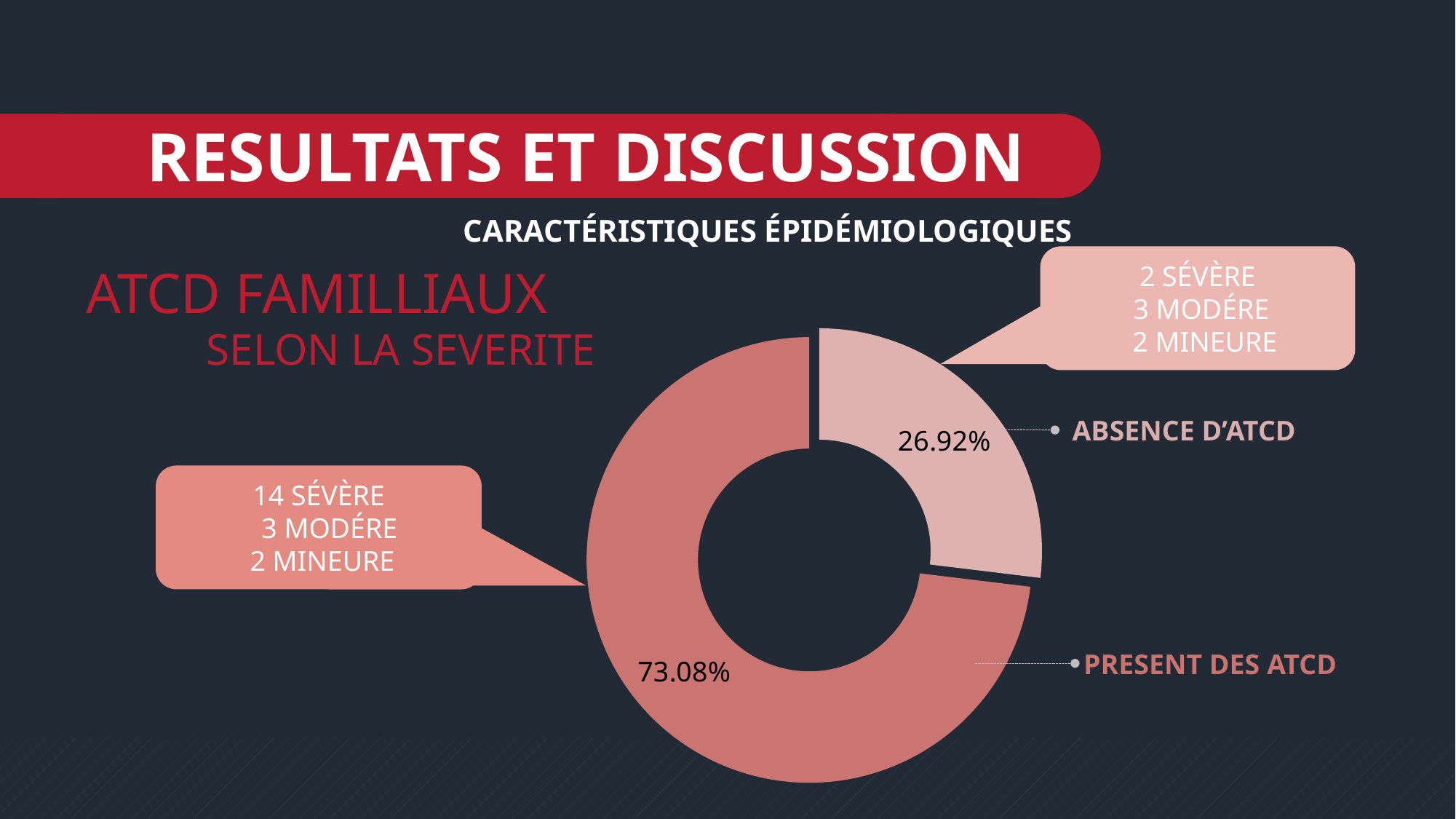
Which slice of the pie chart is the smallest? ABSENCE D'ATCD What kind of chart is shown on the slide? Pie chart (donut) Which is larger, the PRESENT DES ATCD slice or the ABSENCE D'ATCD slice? PRESENT DES ATCD Which slice of the pie chart is drawn in the lighter pink colour? ABSENCE D'ATCD According to the callout for the ABSENCE D'ATCD slice, how many cases are modére? 3 What is the title of the chart shown in red text on the left of the slide? ATCD FAMILLIAUX SELON LA SEVERITE What percentage of the pie chart is labelled PRESENT DES ATCD? 73.08% How many slices does the pie chart have? 2 Which slice of the pie chart is the largest? PRESENT DES ATCD What percentage of the pie chart is labelled ABSENCE D'ATCD? 26.92% According to the callout for the PRESENT DES ATCD slice, how many cases are sévère? 14 What is the difference in percentage points between the PRESENT DES ATCD slice and the ABSENCE D'ATCD slice? 46.16